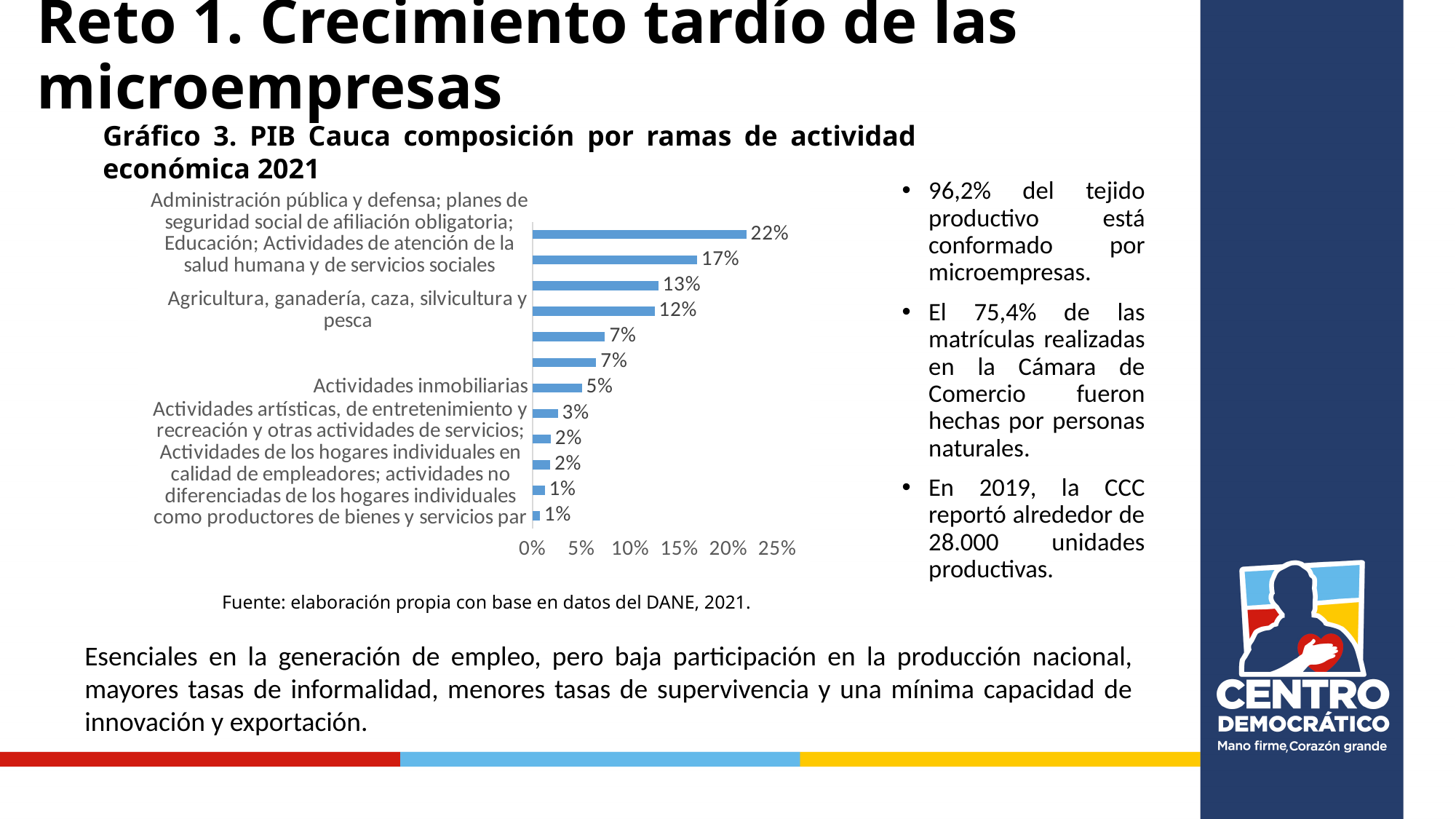
What is the highest value shown in the chart? 22% Which is larger: the value for 'Agricultura, ganadería, caza, silvicultura y pesca' or the value for 'Actividades inmobiliarias'? Agricultura, ganadería, caza, silvicultura y pesca What is the value for 'Agricultura, ganadería, caza, silvicultura y pesca'? 12% What is the difference between the value for 'Administración pública y defensa...' (22%) and the value for 'Agricultura, ganadería, caza, silvicultura y pesca' (12%)? 10 percentage points What is the lowest value shown in the chart? 1% Is the value for 'Administración pública y defensa...' greater or less than 20%? greater What kind of chart is shown on the slide? Bar chart What is the value for 'Actividades inmobiliarias'? 5% How many bars are plotted in the chart? 12 What is the value for 'Administración pública y defensa; planes de seguridad social de afiliación obligatoria; Educación; Actividades de atención de la salud humana y de servicios sociales'? 22% What is the title of the chart on the slide? Gráfico 3. PIB Cauca composición por ramas de actividad económica 2021 What is the source cited below the chart? Fuente: elaboración propia con base en datos del DANE, 2021.